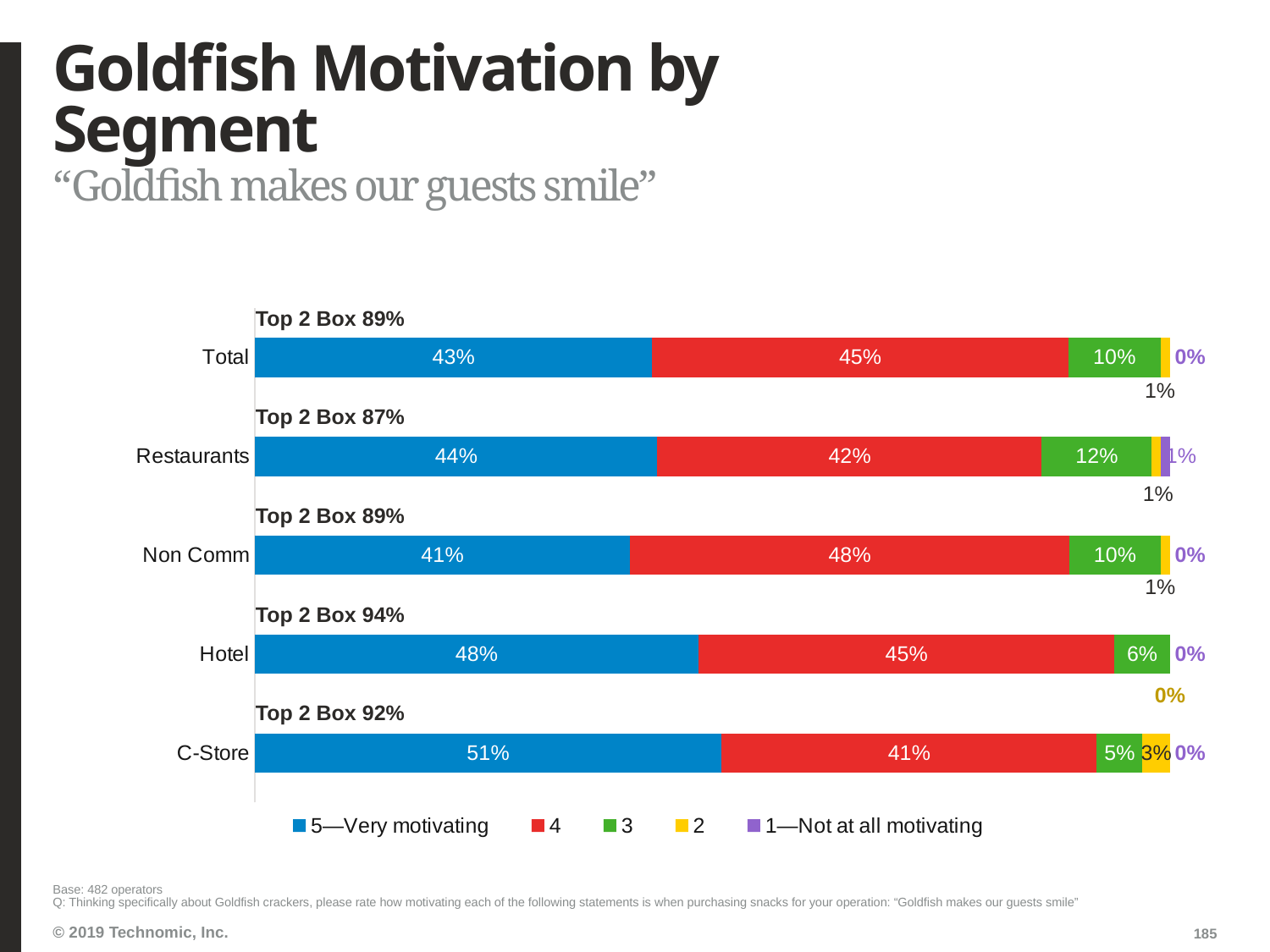
What is the difference between the Hotel and Total Top 2 Box scores? 5 percentage points Which legend entry is shown in blue? 5—Very motivating Which is larger: the '4' rating share for Total or for Restaurants? Total What is the Top 2 Box score for the Hotel segment? 94% Which segment has the highest share of 5—Very motivating ratings? C-Store What type of chart is shown on the slide? Stacked bar chart What is the value for the '4' rating in the Non Comm segment? 48% What percentage of C-Store operators rated the statement 5—Very motivating? 51% How many series does the legend list? 5 What percentage of Restaurants operators gave a rating of 3? 12% Which segment has the lowest share of 5—Very motivating ratings? Non Comm How many segments are shown in the chart? 5